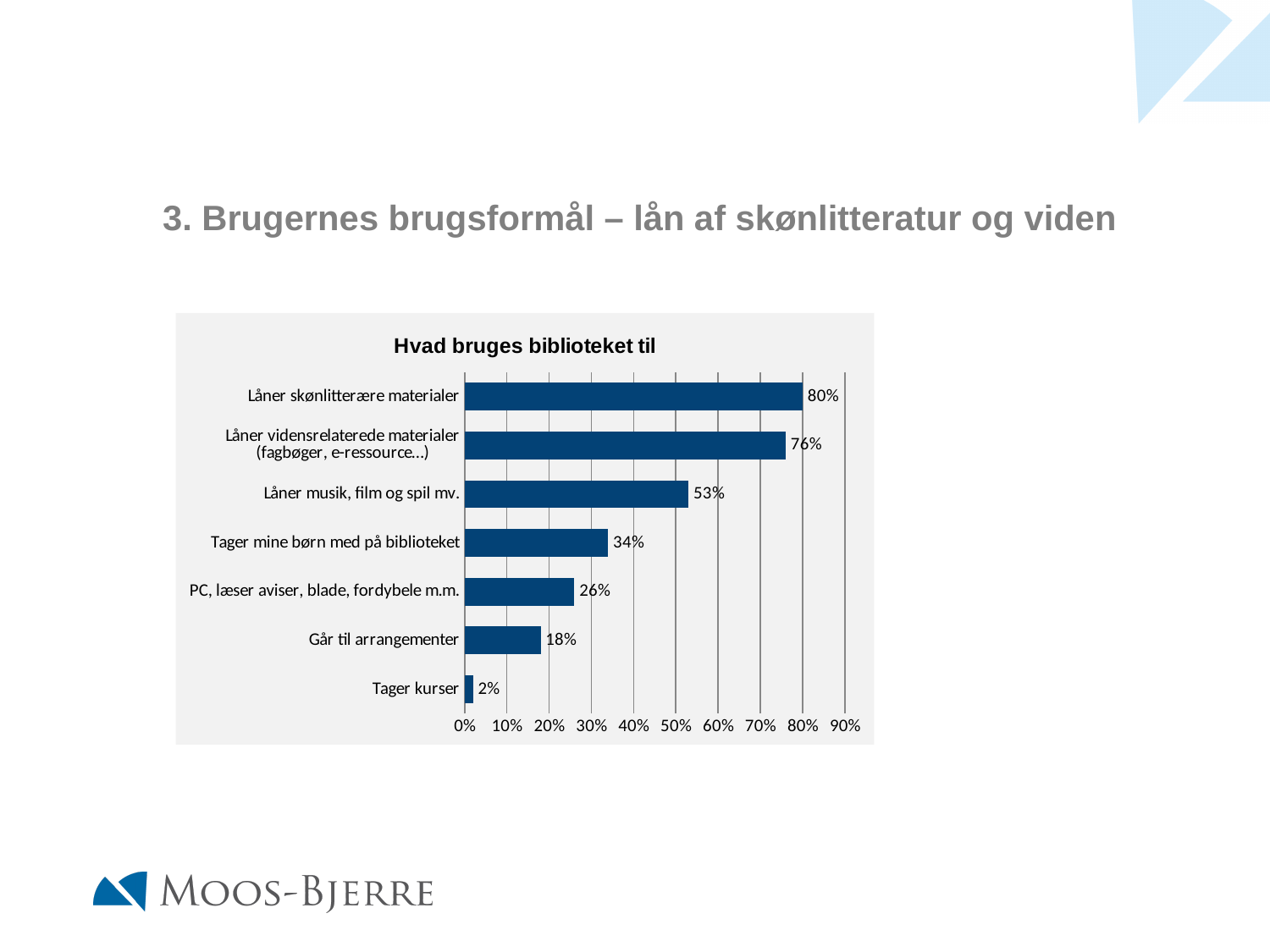
What is the value for "Tager mine børn med på biblioteket"? 34% Is the value for "Låner musik, film og spil mv." greater or less than 50%? greater What is the title of the chart? Hvad bruges biblioteket til What is the difference between "Låner skønlitterære materialer" and "Låner vidensrelaterede materialer (fagbøger, e-ressource...)"? 4% Which category has the highest value? Låner skønlitterære materialer What is the value for "Låner skønlitterære materialer"? 80% What kind of chart is shown? Bar chart Which category has the lowest value? Tager kurser Which is larger: "Tager mine børn med på biblioteket" or "Går til arrangementer"? Tager mine børn med på biblioteket What is the value for "Går til arrangementer"? 18% What is the difference between "Låner musik, film og spil mv." and "PC, læser aviser, blade, fordybele m.m."? 27% How many categories are shown in the chart? 7